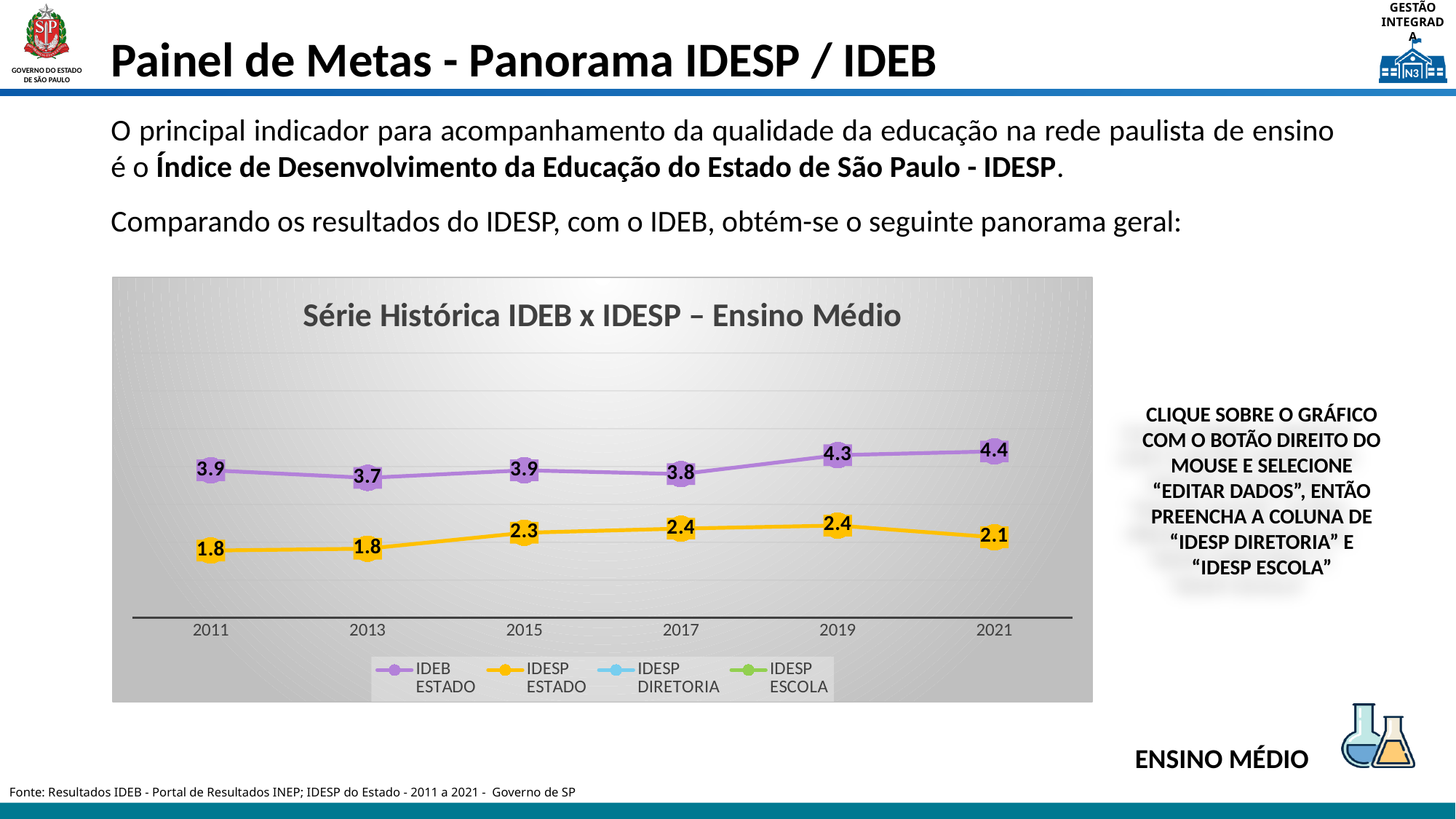
How many series does the legend list? 4 What kind of chart is shown on the slide? Line chart What is the value of IDESP ESTADO in 2021? 2.1 In which year is IDEB ESTADO lowest? 2013 How many years are shown on the x axis? 6 What is the value of IDEB ESTADO in 2019? 4.3 By how much did IDEB ESTADO change from 2017 to 2019? 0.5 In which year is IDEB ESTADO highest? 2021 What is the difference between IDEB ESTADO and IDESP ESTADO in 2011? 2.1 What is the title of the chart? Série Histórica IDEB x IDESP – Ensino Médio Which is larger in 2021, IDEB ESTADO or IDESP ESTADO? IDEB ESTADO What is the value of IDESP ESTADO in 2015? 2.3